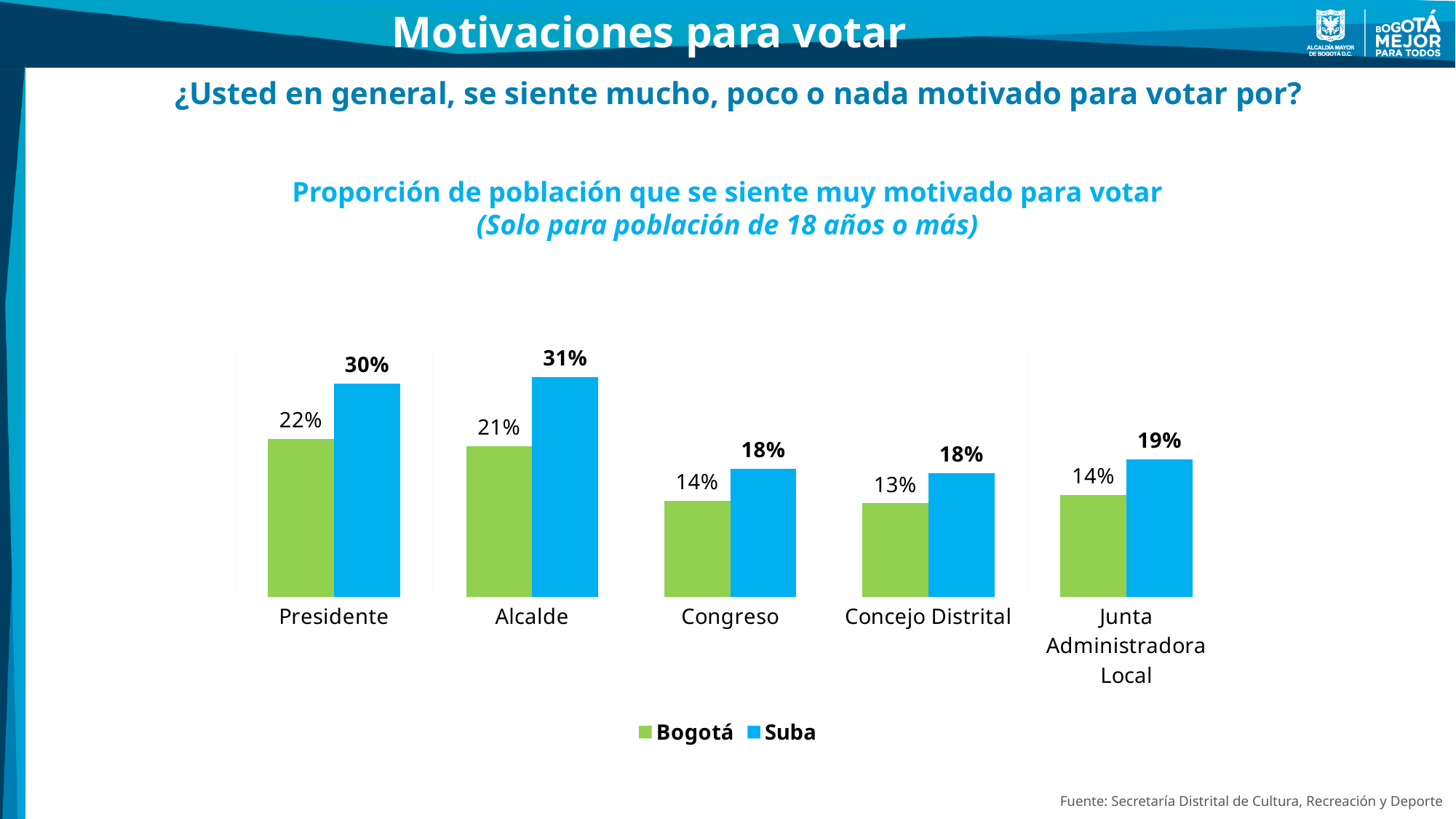
How many series does the legend list? 2 Which is larger for Congreso, the Bogotá value or the Suba value? Suba Which category has the highest value for Suba? Alcalde Which colour represents the Suba series in the legend? Blue What is the value for Suba for Junta Administradora Local? 19% How many categories are shown on the x axis? 5 What is the value for Bogotá for Presidente? 22% What is the value for Suba for Alcalde? 31% What kind of chart is shown on the slide? Bar chart What is the difference between the Suba and Bogotá values for Alcalde? 10% What is the value for Bogotá for Concejo Distrital? 13% Which category has the lowest value for Bogotá? Concejo Distrital